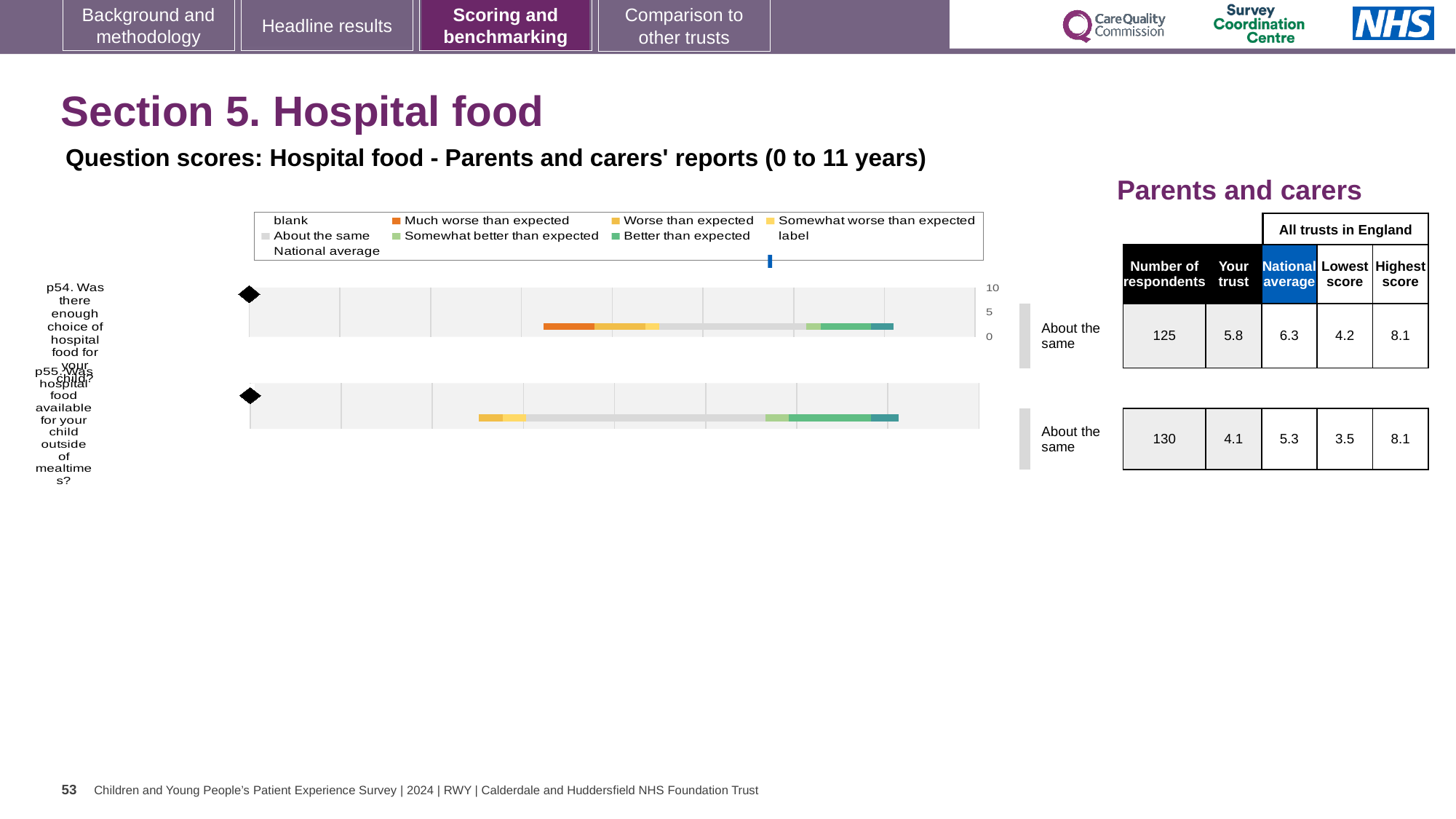
What is the highest score among all trusts in England for p54? 8.1 How many respondents answered p55? 130 Which question has the higher 'Your trust' score, p54 or p55? p54 What is the national average score for p55? 5.3 What is the lowest score among all trusts in England for p55? 3.5 What is the 'Your trust' score for p55 (hospital food available outside of mealtimes)? 4.1 How many survey questions are plotted in the hospital food chart? 2 What kind of chart is used to show the question scores? Bar chart By how much is the national average higher than the trust's score for p54? 0.5 What is the national average score for p54? 6.3 What is the 'Your trust' score for p54 (enough choice of hospital food for your child)? 5.8 What benchmark category is shown for p55? About the same